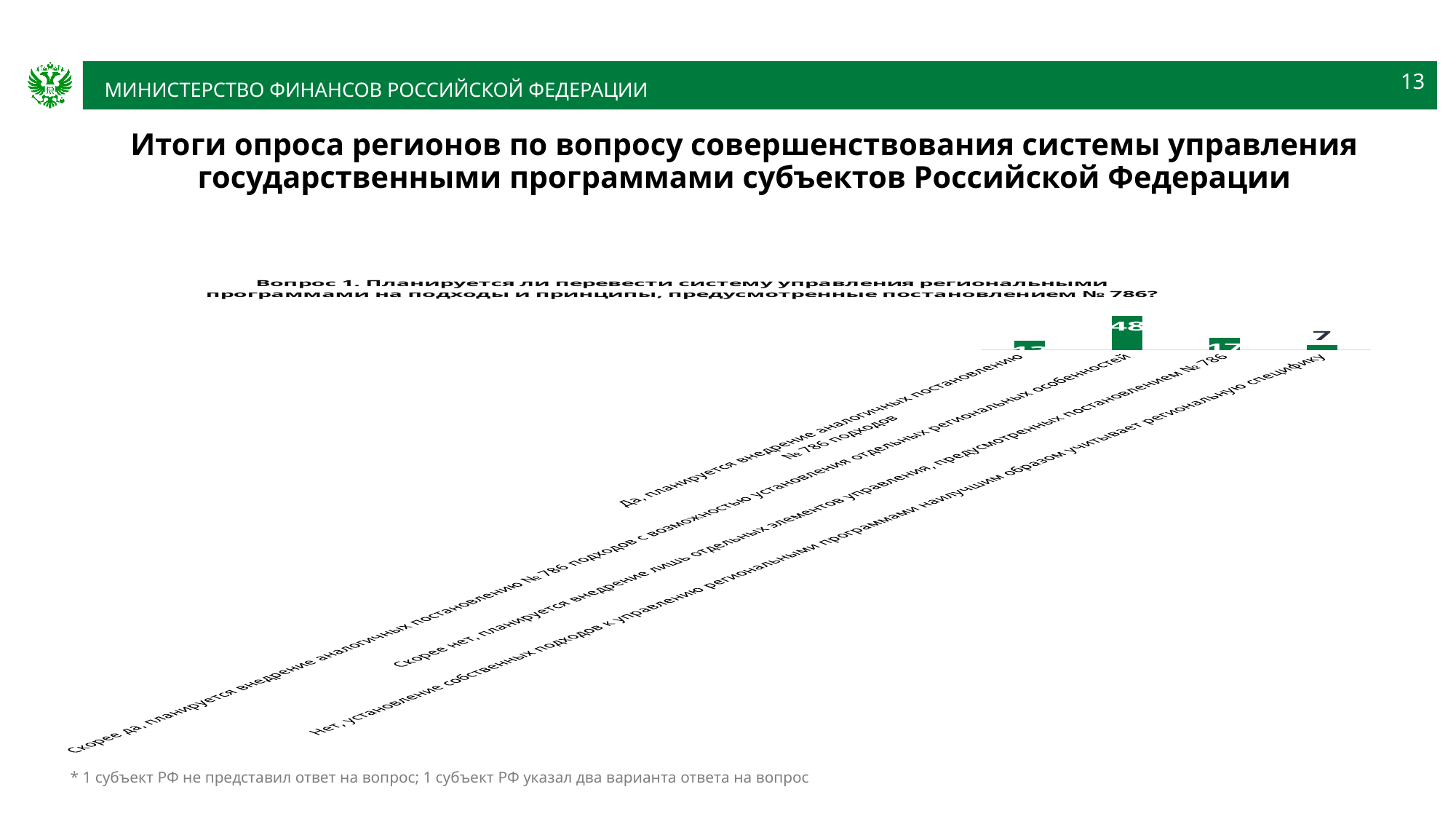
What is the difference between the value for 'Скорее да...' (48) and the value for 'Нет...' (7)? 41 Which answer category has the highest value in the chart? Скорее да, планируется внедрение аналогичных постановлению № 786 подходов с возможностью установления отдельных региональных особенностей How many answer categories are plotted in the chart? 4 What kind of chart is shown on the slide? bar chart What is the title of the chart? Вопрос 1. Планируется ли перевести систему управления региональными программами на подходы и принципы, предусмотренные постановлением № 786? What is the value for the category 'Нет, установление собственных подходов к управлению региональными программами наилучшим образом учитывает региональную специфику'? 7 What colour are the bars in the chart? green Which is larger: the value for 'Скорее да, планируется внедрение аналогичных постановлению № 786 подходов с возможностью установления отдельных региональных особенностей' or the value for 'Нет, установление собственных подходов к управлению региональными программами наилучшим образом учитывает региональную специфику'? Скорее да, планируется внедрение аналогичных постановлению № 786 подходов с возможностью установления отдельных региональных особенностей What is the value for the category 'Скорее да, планируется внедрение аналогичных постановлению № 786 подходов с возможностью установления отдельных региональных особенностей'? 48 Which answer category has the lowest value in the chart? Нет, установление собственных подходов к управлению региональными программами наилучшим образом учитывает региональную специфику